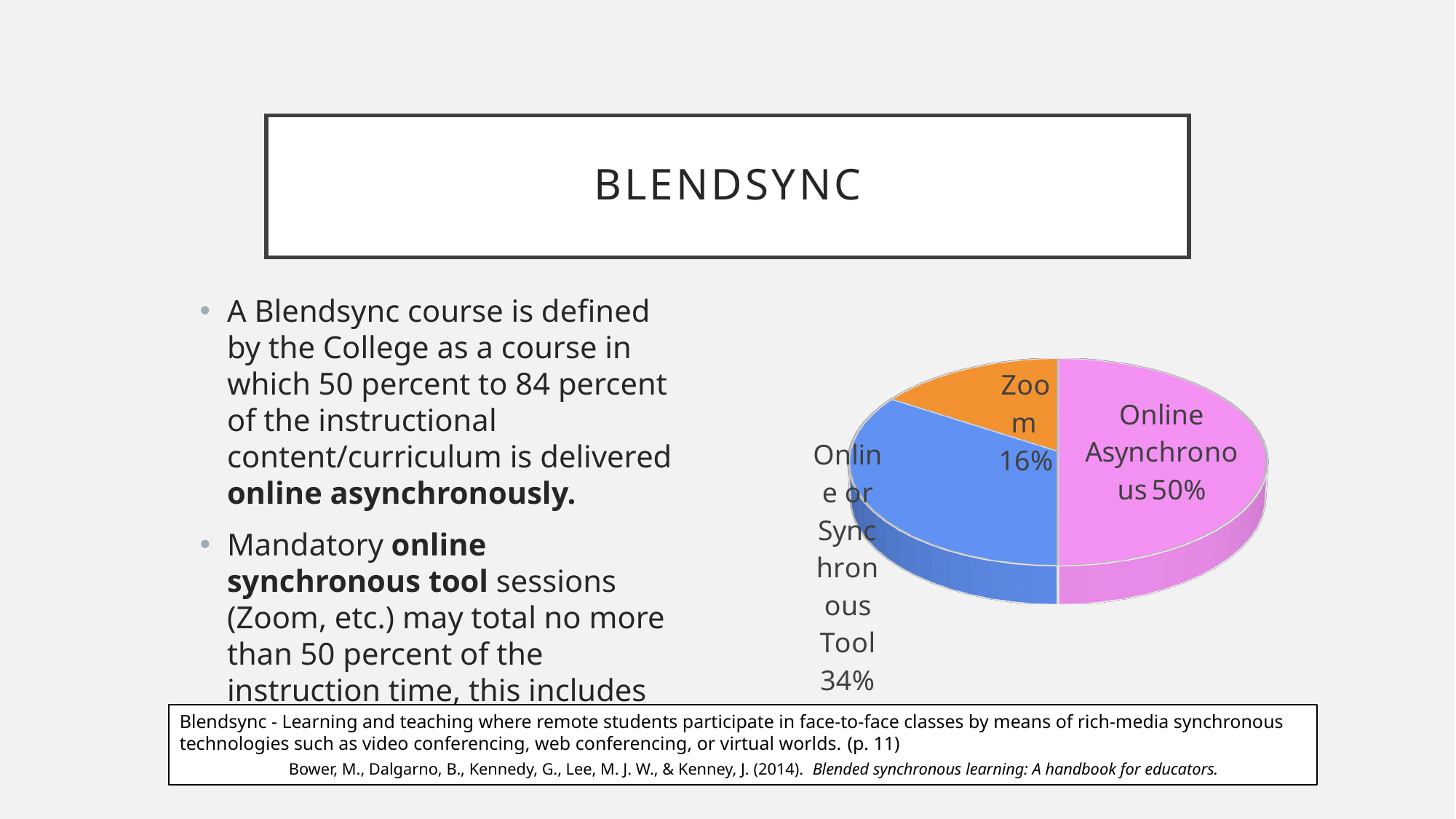
Which slice of the pie is the smallest? Zoom What share of the pie does Zoom represent? 16% What is the difference in percentage points between Online Asynchronous and Zoom? 34 How many slices does the pie chart have? 3 What share of the pie does Online or Synchronous Tool represent? 34% What colour is the Online Asynchronous slice? pink What colour is the Zoom slice? orange What is the difference in percentage points between Online or Synchronous Tool and Zoom? 18 What kind of chart is shown on the slide? pie chart Which slice of the pie is the largest? Online Asynchronous Which is larger, the Online or Synchronous Tool slice or the Zoom slice? Online or Synchronous Tool What share of the pie does Online Asynchronous represent? 50%